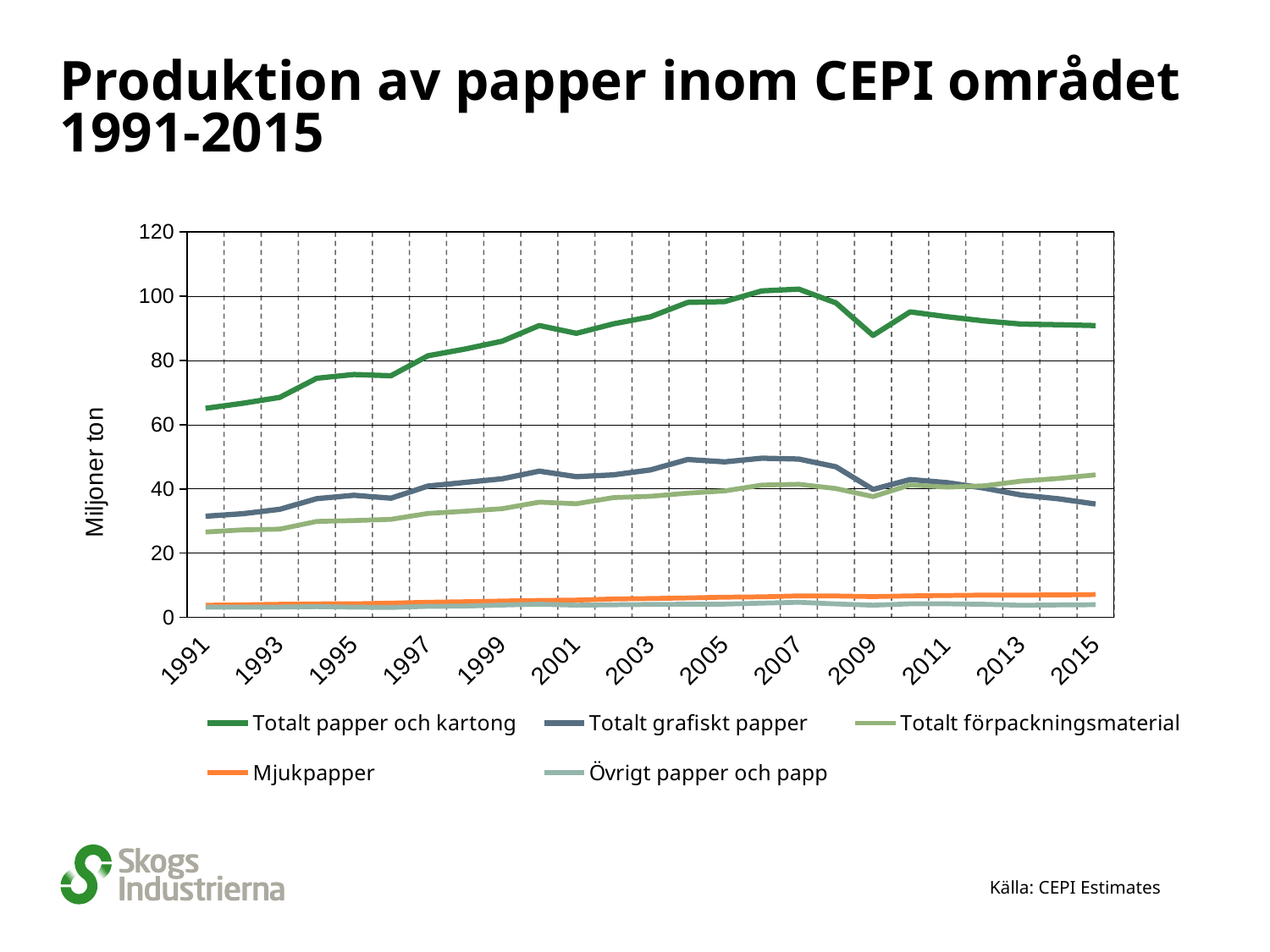
What kind of chart is shown on the slide? line chart Is the value for Totalt grafiskt papper in 2015 greater or less than 40? less In 1991, which is larger: Totalt grafiskt papper or Totalt förpackningsmaterial? Totalt grafiskt papper Is the value for Totalt förpackningsmaterial in 2015 greater or less than 40? greater Is the value for Totalt papper och kartong in 1991 greater or less than 80? less How many series does the legend list? 5 Does Totalt grafiskt papper rise or fall between 2007 and 2015? fall Which series has the highest values throughout the chart? Totalt papper och kartong Which series has the lowest values throughout the chart? Övrigt papper och papp What is the label on the y axis? Miljoner ton In 2015, which is larger: Totalt grafiskt papper or Totalt förpackningsmaterial? Totalt förpackningsmaterial